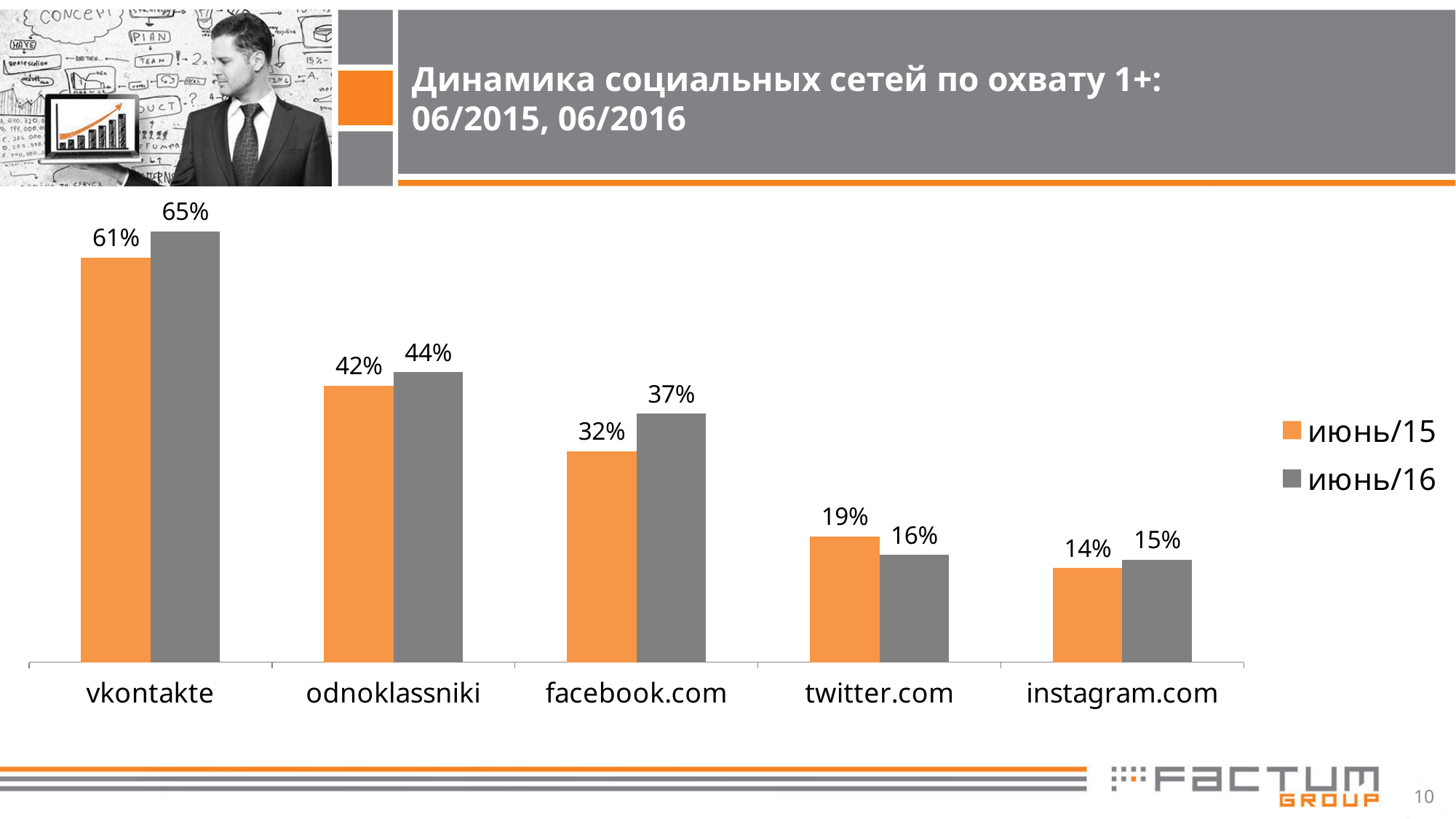
Which is larger for odnoklassniki: the июнь/15 value or the июнь/16 value? июнь/16 What is the difference between the июнь/15 and июнь/16 values for twitter.com? 3% How many series does the legend list? 2 What is the value for twitter.com in the июнь/16 series? 16% What is the value for vkontakte in the июнь/16 series? 65% What is the value for facebook.com in the июнь/15 series? 32% How many categories are shown on the x axis? 5 Which category has the lowest value in the июнь/16 series? instagram.com What kind of chart is shown on the slide? bar chart What is the difference between the июнь/16 and июнь/15 values for facebook.com? 5% Which colour represents the июнь/15 series? orange Which category has the highest value in the июнь/15 series? vkontakte